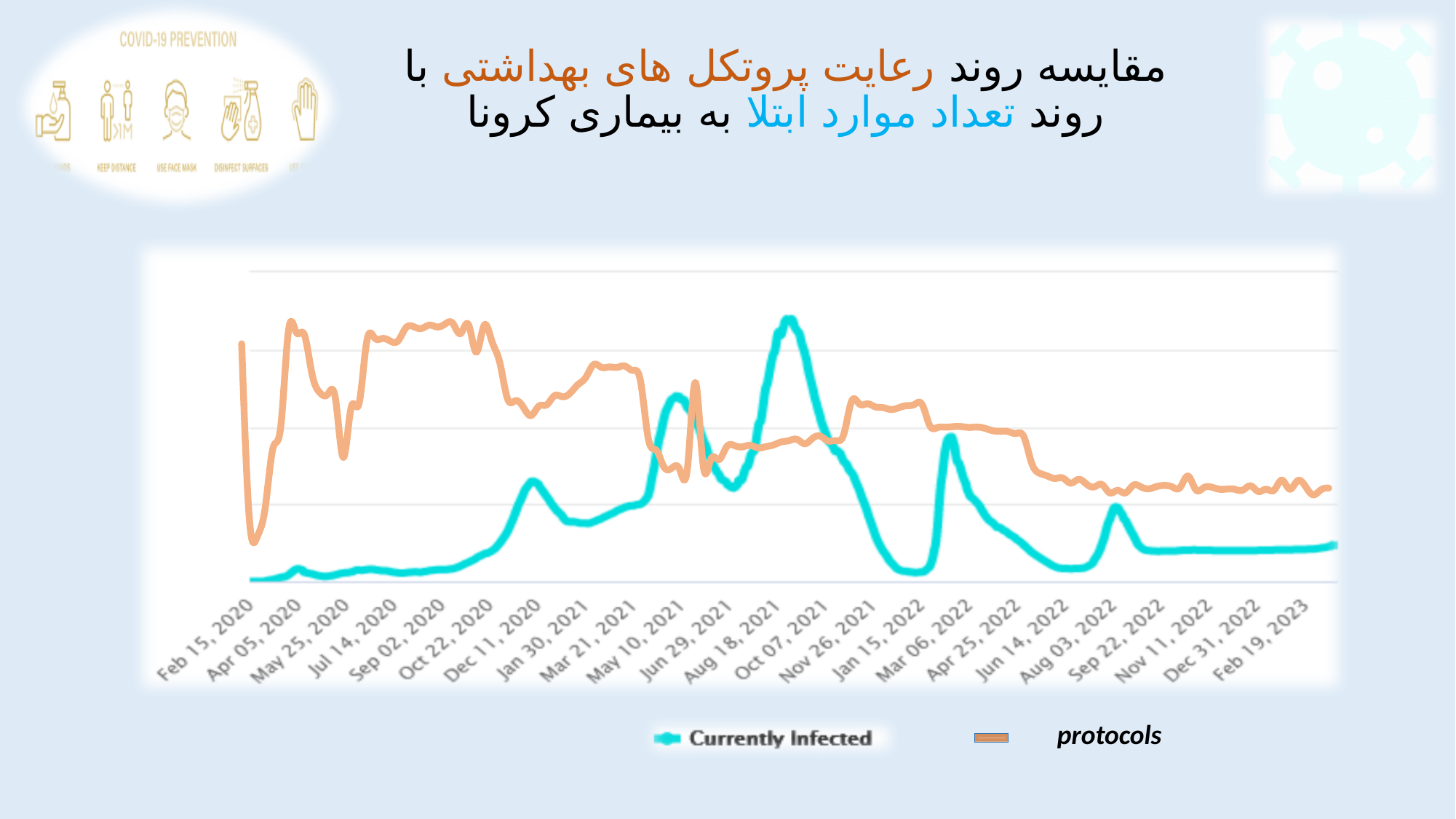
What colour is the Currently Infected line? Cyan (turquoise) In which year does the Currently Infected line reach its highest point? 2021 What kind of chart is shown on the slide? Line chart At Feb 19, 2023, which series is higher, Currently Infected or protocols? protocols What are the two series named in the legend? Currently Infected and protocols How many date labels are shown on the x axis? 23 What is the first date label on the x axis? Feb 15, 2020 Does the protocols line rise or fall between Mar 06, 2022 and Jun 14, 2022? Fall At Feb 15, 2020, which series is higher, Currently Infected or protocols? protocols What is the last date label on the x axis? Feb 19, 2023 How many series does the legend list? 2